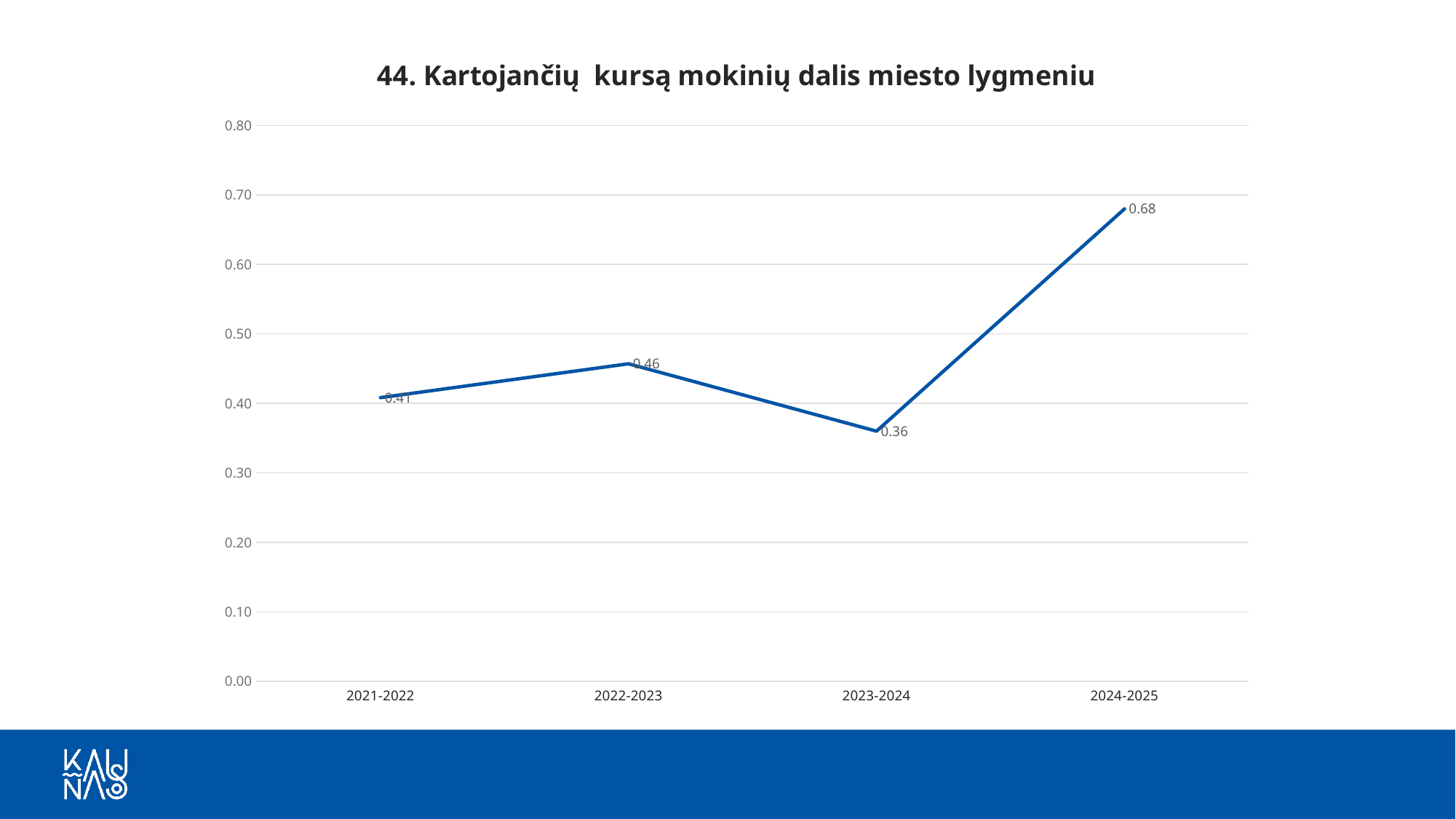
What is the value for 2021-2022? 0.41 Is the value for 2024-2025 greater or less than 0.60? greater Which school year has the highest value? 2024-2025 Which is larger, the value for 2021-2022 or the value for 2022-2023? 2022-2023 What is the value for 2024-2025? 0.68 What is the value for 2023-2024? 0.36 Which school year has the lowest value? 2023-2024 What is the difference between the values for 2024-2025 and 2023-2024? 0.32 What is the value for 2022-2023? 0.46 What kind of chart is shown on the slide? line chart What is the title of the chart? 44. Kartojančių kursą mokinių dalis miesto lygmeniu How many school years are plotted on the chart? 4